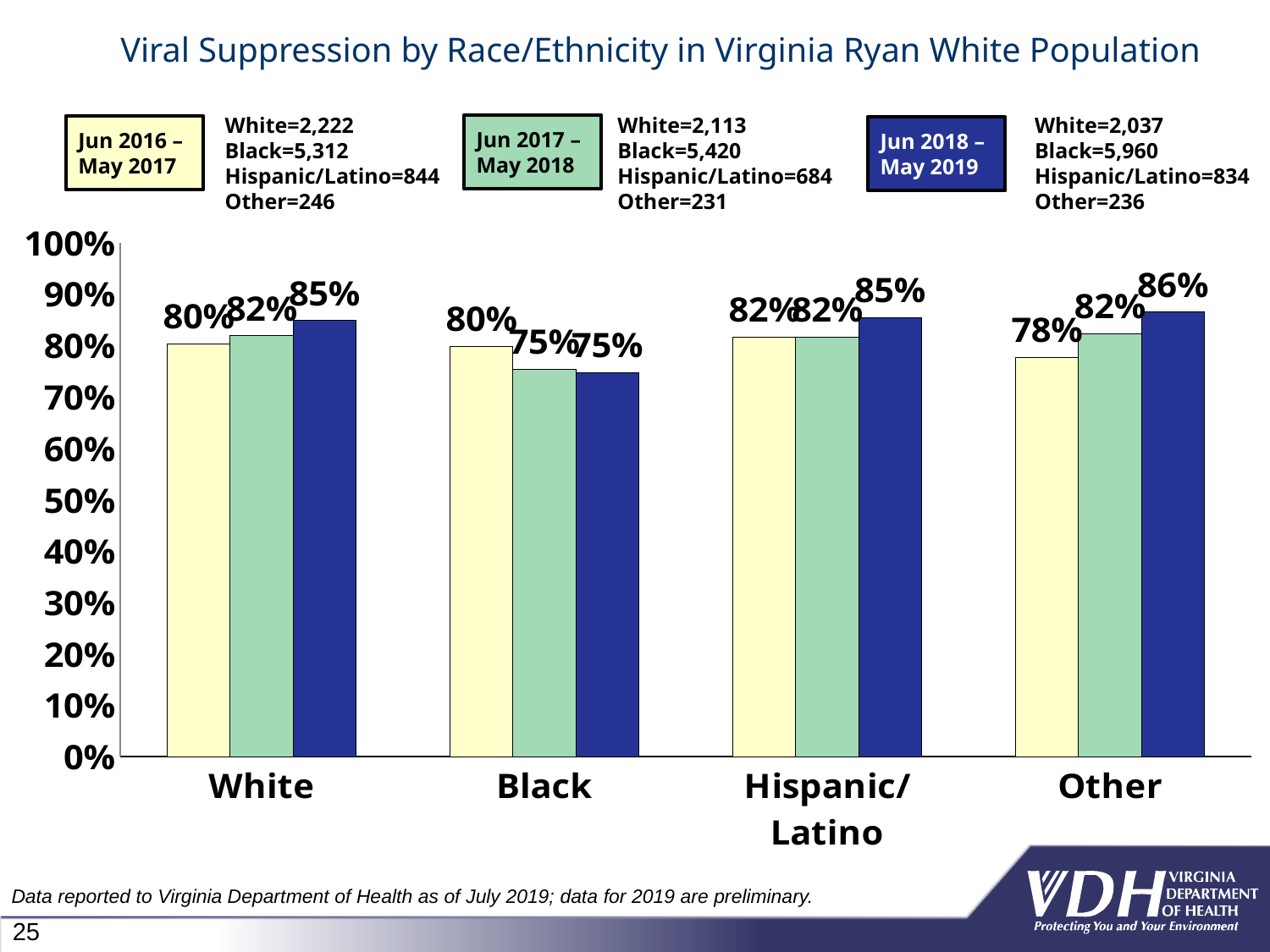
Which race/ethnicity category has the lowest value in Jun 2017 – May 2018? Black What is the viral suppression value for Black in Jun 2017 – May 2018? 75% Across the three time periods, do the values for White rise or fall? Rise Which is larger: the Black value in Jun 2016 – May 2017 or the Black value in Jun 2018 – May 2019? Jun 2016 – May 2017 Which race/ethnicity category has the highest value in Jun 2018 – May 2019? Other How many race/ethnicity categories are shown on the x axis? 4 How many time periods (series) does the chart show? 3 What is the viral suppression value for Other in Jun 2016 – May 2017? 78% What is the viral suppression value for Hispanic/Latino in Jun 2018 – May 2019? 85% What is the difference between the Other value in Jun 2018 – May 2019 and the Other value in Jun 2016 – May 2017? 8% What is the viral suppression value for White in Jun 2018 – May 2019? 85% What kind of chart is shown on the slide? Bar chart